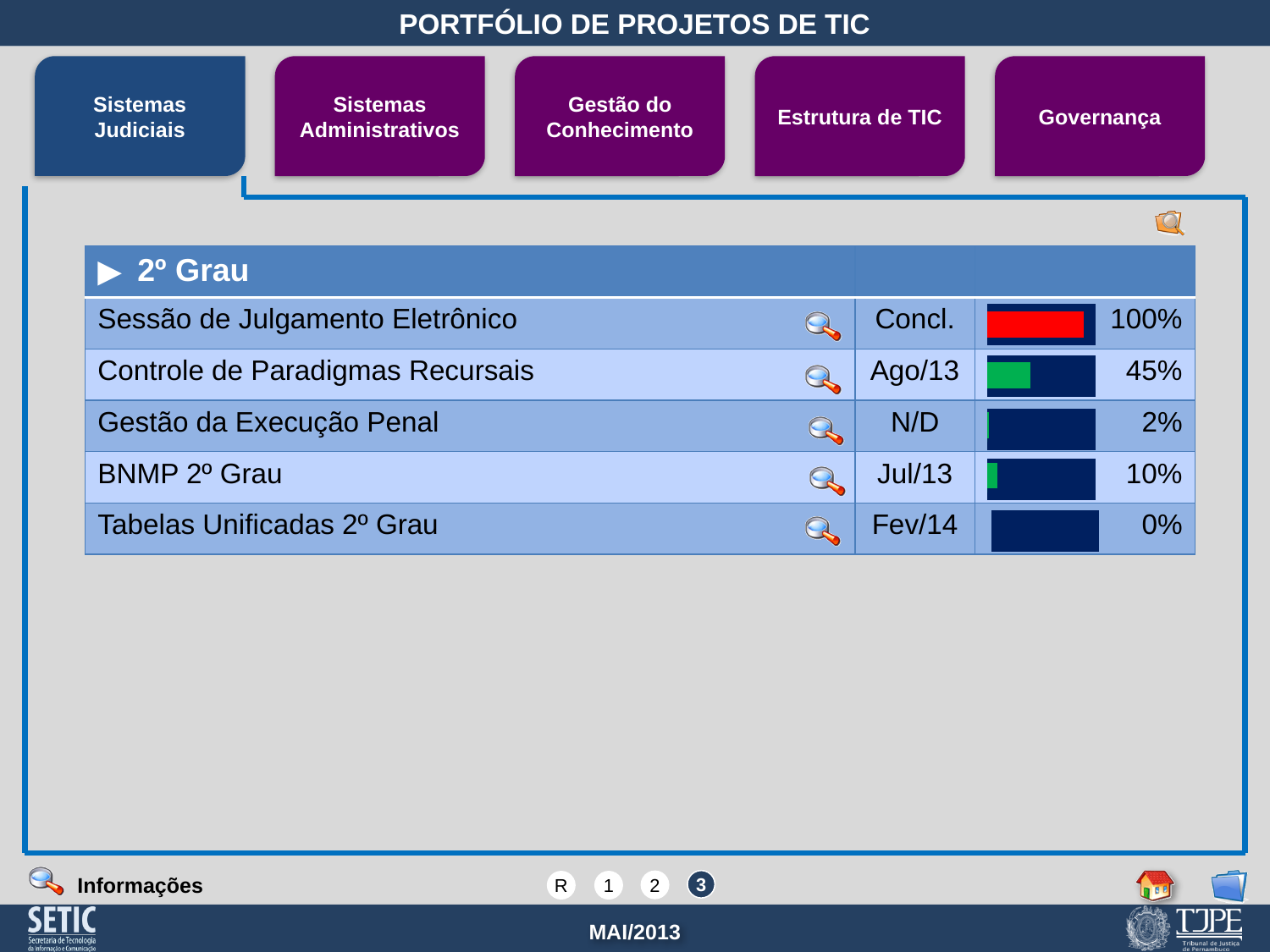
What colour is the progress bar for Sessão de Julgamento Eletrônico? Red What is the completion percentage shown for Gestão da Execução Penal? 2% What is the completion percentage shown for Sessão de Julgamento Eletrônico? 100% What kind of chart is used to show each project's progress in the 2º Grau table? Bar chart What is the completion percentage shown for BNMP 2º Grau? 10% Which has a higher completion percentage, Gestão da Execução Penal or BNMP 2º Grau? BNMP 2º Grau What is the difference in completion percentage between Controle de Paradigmas Recursais and BNMP 2º Grau? 35% What is the completion percentage shown for Controle de Paradigmas Recursais? 45% How many projects are listed in the 2º Grau table with progress bars? 5 Which project in the 2º Grau table has the lowest completion percentage? Tabelas Unificadas 2º Grau What is the completion percentage shown for Tabelas Unificadas 2º Grau? 0% Which project in the 2º Grau table has the highest completion percentage? Sessão de Julgamento Eletrônico